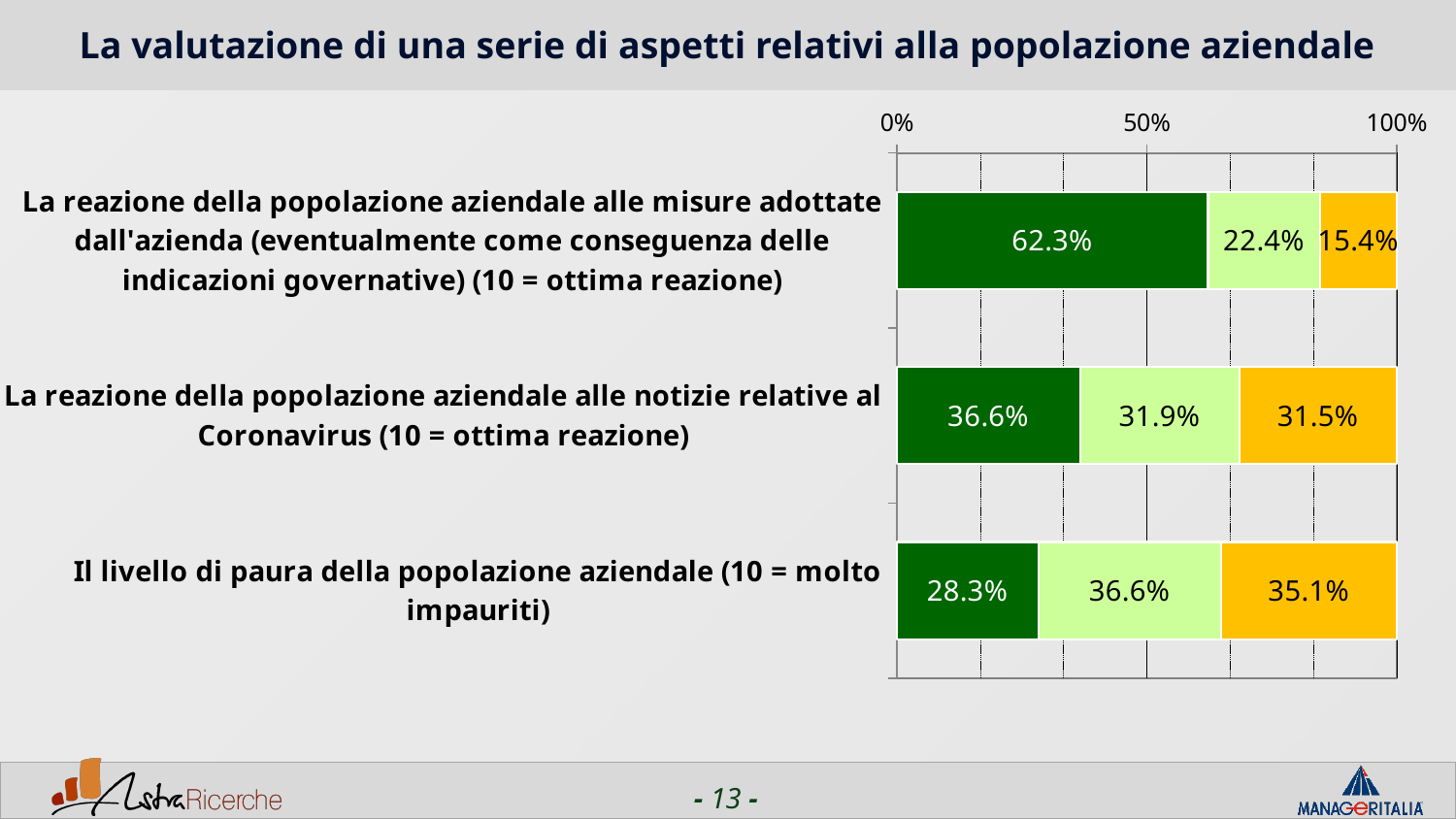
Which is larger: the orange segment for 'Il livello di paura della popolazione aziendale' or the orange segment for 'La reazione della popolazione aziendale alle misure adottate dall'azienda'? Il livello di paura della popolazione aziendale What is the value of the orange segment for 'La reazione della popolazione aziendale alle misure adottate dall'azienda'? 15.4% What is the title of the slide containing the chart? La valutazione di una serie di aspetti relativi alla popolazione aziendale Which category has the lowest dark green segment value? Il livello di paura della popolazione aziendale Is the dark green segment value for 'La reazione della popolazione aziendale alle misure adottate dall'azienda' greater or less than 50%? greater What is the difference between the dark green segment values for 'La reazione della popolazione aziendale alle misure adottate dall'azienda' and 'La reazione della popolazione aziendale alle notizie relative al Coronavirus'? 25.7% Which category has the highest dark green segment value? La reazione della popolazione aziendale alle misure adottate dall'azienda What is the value of the orange segment for 'La reazione della popolazione aziendale alle notizie relative al Coronavirus'? 31.5% What kind of chart is shown on the slide? stacked bar chart How many categories (bars) does the chart show? 3 What is the value of the light green segment for 'Il livello di paura della popolazione aziendale'? 36.6% What is the value of the dark green segment for 'La reazione della popolazione aziendale alle misure adottate dall'azienda'? 62.3%